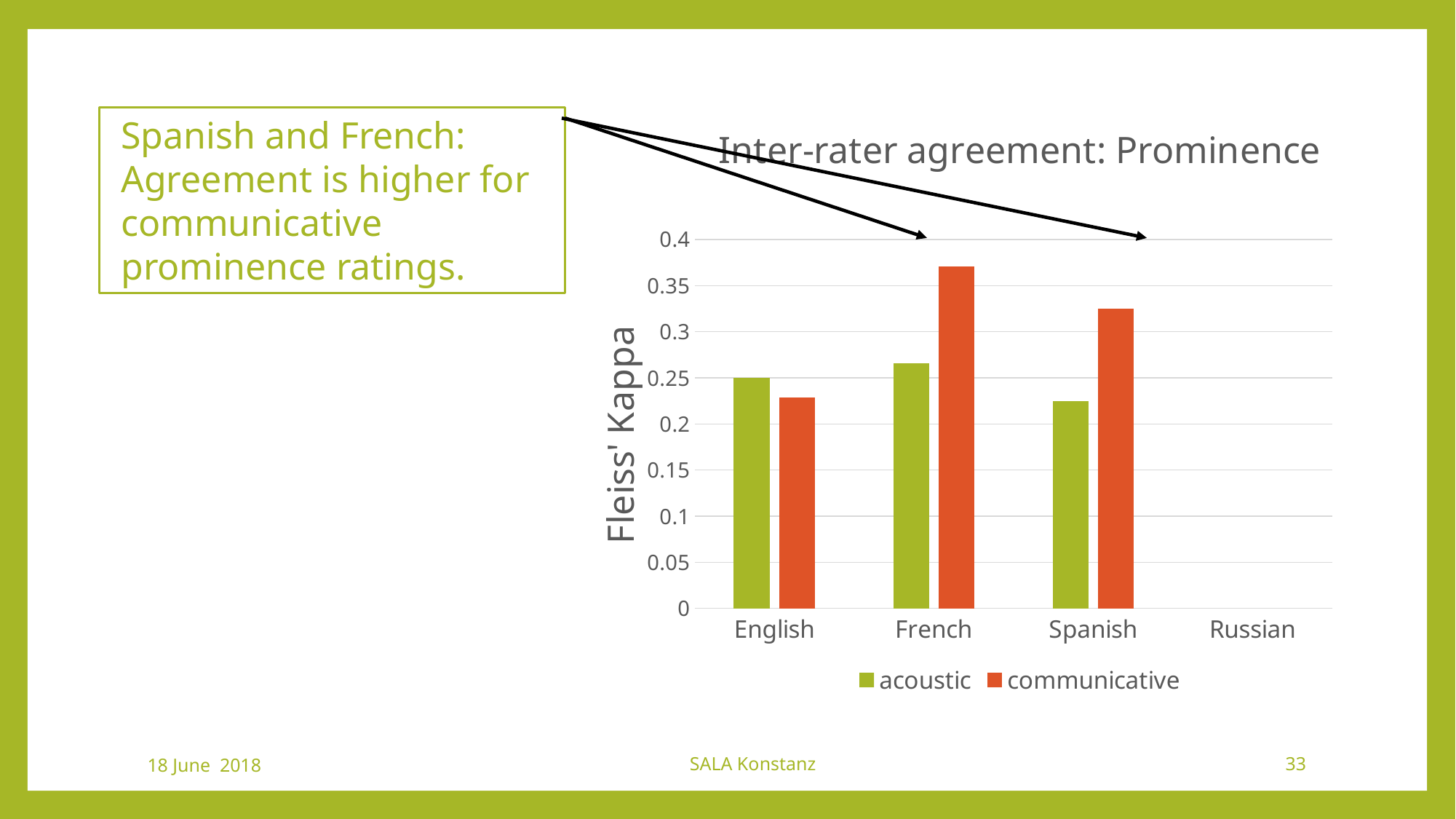
For French, which is larger: the acoustic value or the communicative value? communicative What is the title of the chart? Inter-rater agreement: Prominence Is the communicative value for Spanish greater or less than 0.3? greater How many language categories are shown on the x axis? 4 What kind of chart is shown on the slide? bar chart How many series does the legend list? 2 Which language has the lowest acoustic bar among those with bars shown? Spanish Is the communicative value for English greater or less than 0.25? less Which language has the highest communicative bar? French Is the communicative value for French greater or less than 0.35? greater What is the label on the vertical axis of the chart? Fleiss' Kappa For English, which is larger: the acoustic value or the communicative value? acoustic